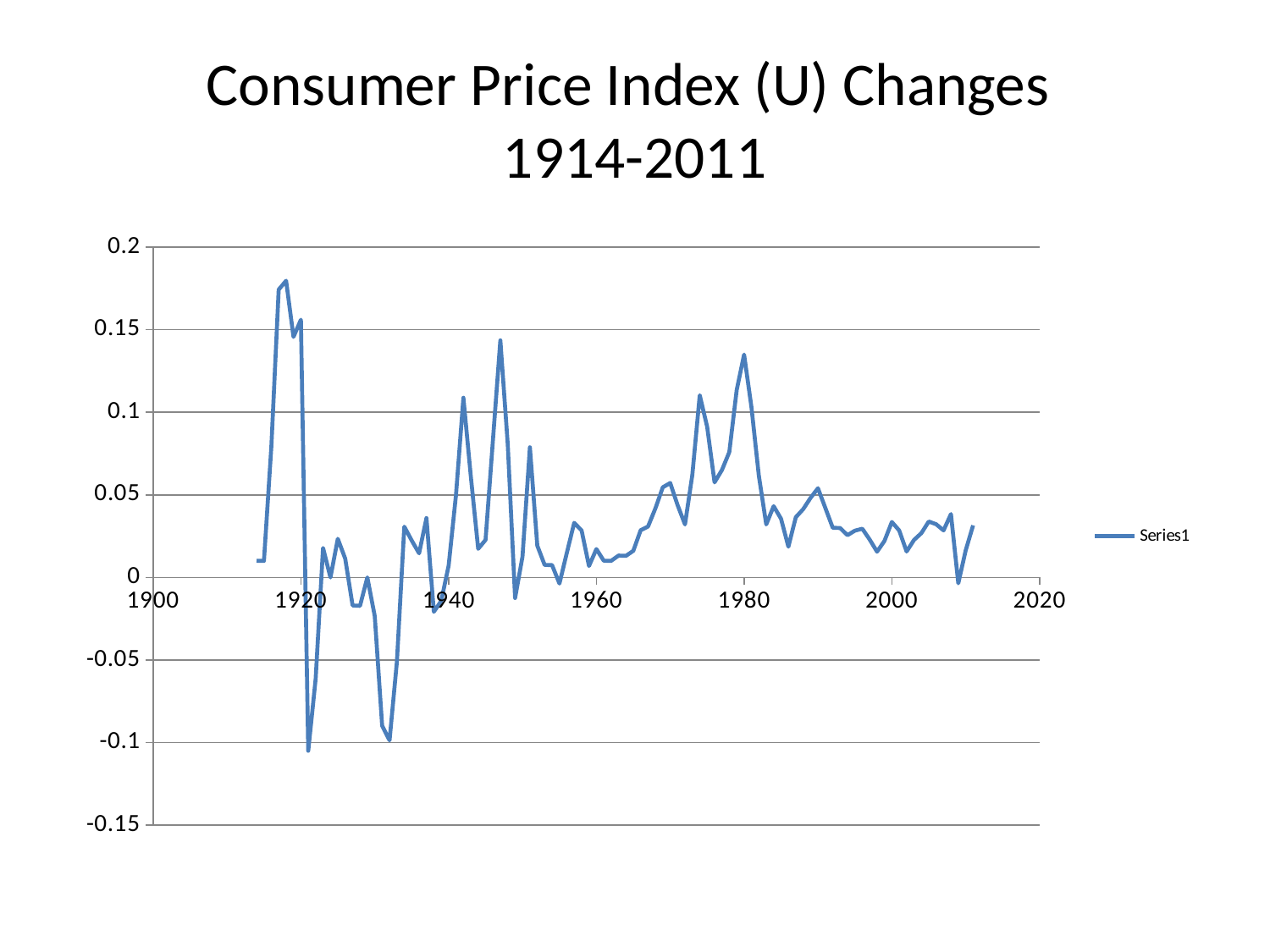
What kind of chart is shown on the slide? line chart Around which year does the line reach its highest value? 1918 Is the peak value around 1918 greater or less than 0.15? greater Is the value around 1921 greater or less than -0.05? less Is the value around 2009 greater or less than 0.05? less What is the name of the series shown in the legend? Series1 What is the title of the chart? Consumer Price Index (U) Changes 1914-2011 How many series does the legend list? 1 Which is larger, the peak around 1918 or the peak around 1980? the peak around 1918 Do the values rise or fall between 1980 and 1986? fall